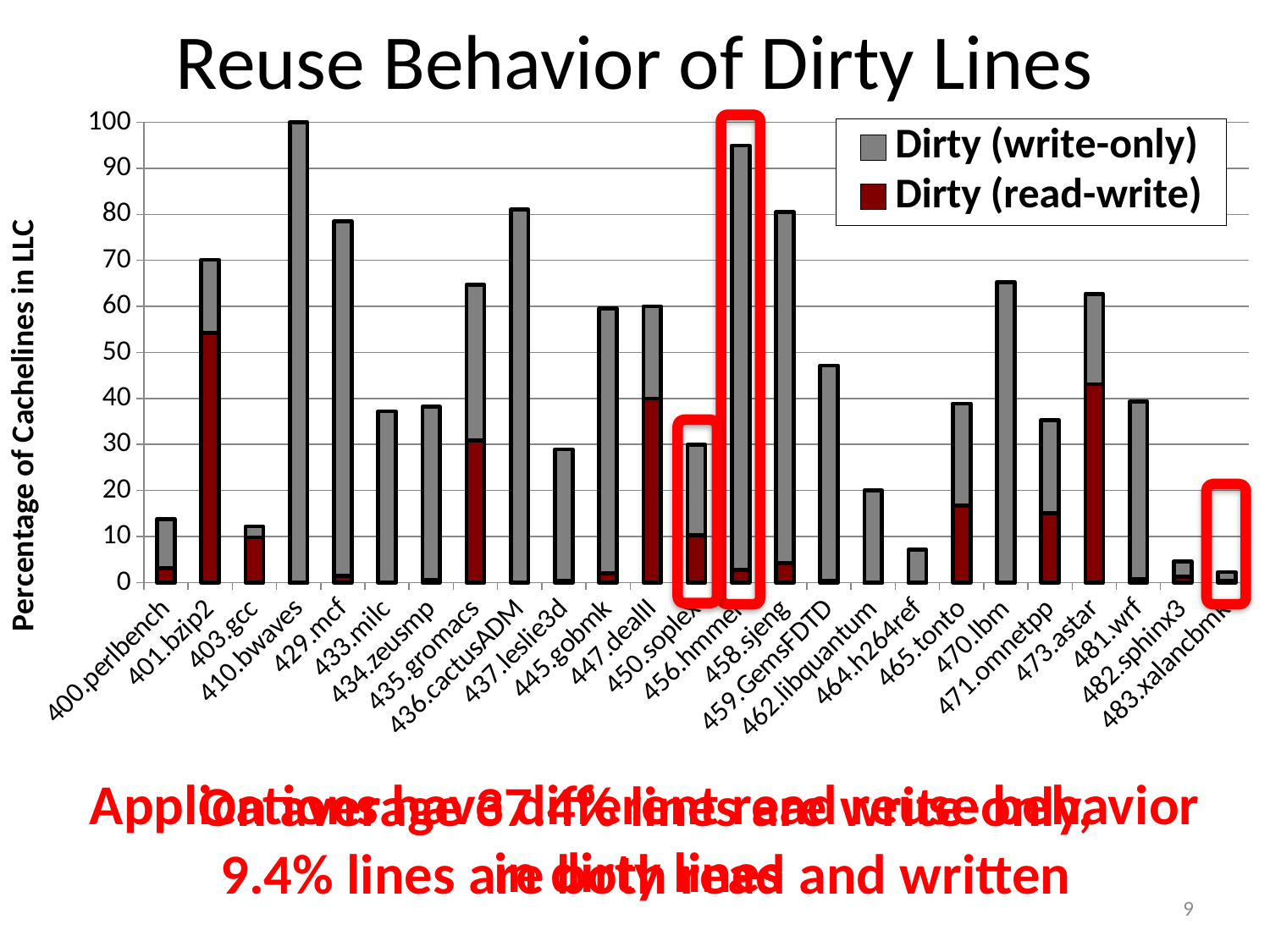
Is the total value for 456.hmmer greater or less than 90? greater Which benchmark has the largest Dirty (read-write) segment? 401.bzip2 What kind of chart is shown on the slide? Stacked bar chart Is the total value for 462.libquantum greater or less than 30? less How many series does the legend list? 2 What is the label of the y axis? Percentage of Cachelines in LLC Which has a larger total value, 458.sjeng or 459.GemsFDTD? 458.sjeng Which colour represents the Dirty (read-write) series in the legend? Dark red Which benchmark has the lowest total percentage of dirty cachelines? 483.xalancbmk Is the total value for 464.h264ref greater or less than 10? less Which benchmark has the highest total percentage of dirty cachelines? 410.bwaves How many benchmark categories are plotted along the x axis? 25